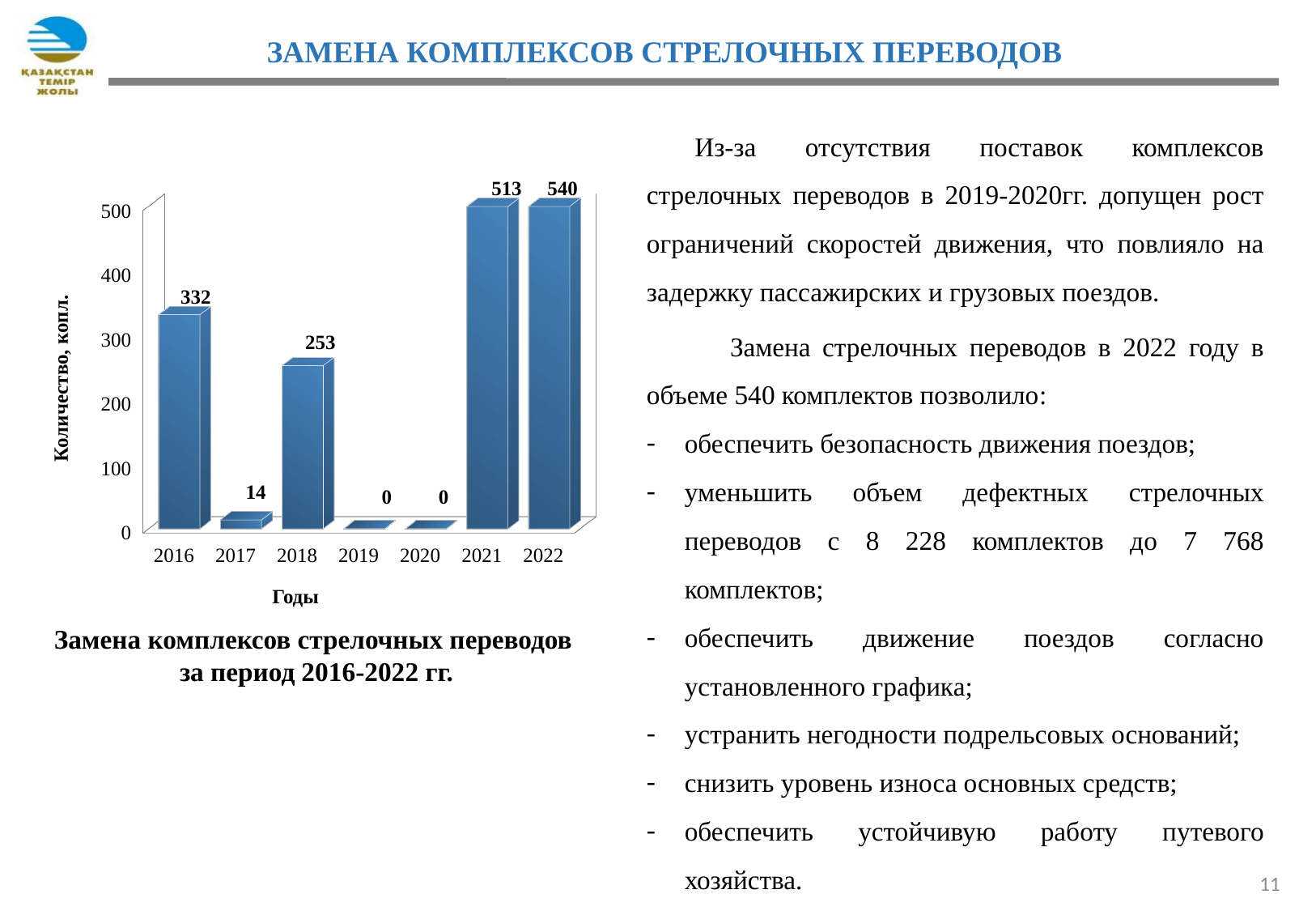
What value is shown for 2018? 253 What value is shown for 2016? 332 Which is larger, the value for 2016 or the value for 2018? 2016 What value is shown for 2022? 540 What kind of chart is shown on the slide? Bar chart What is the difference between the values for 2022 and 2021? 27 What is the label of the y axis? Количество, копл. Which year has the highest value? 2022 What value is shown for 2017? 14 Which years have a value of 0? 2019 and 2020 How many years are shown on the x axis? 7 What is the difference between the values for 2016 and 2018? 79